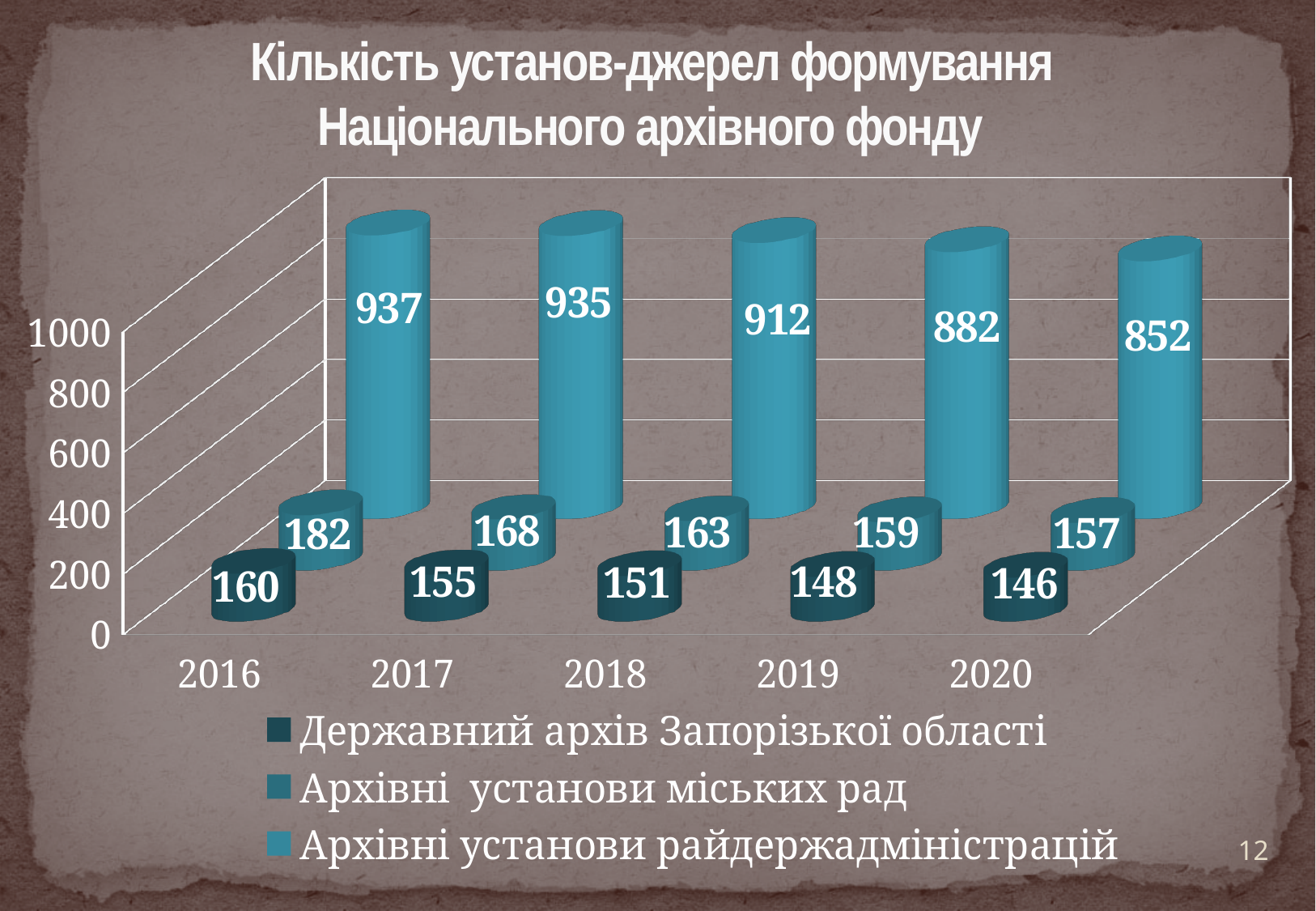
What is the value for Архівні установи райдержадміністрацій in 2016? 937 What is the title of the chart? Кількість установ-джерел формування Національного архівного фонду Which is larger: the 2017 value for Архівні установи міських рад or the 2017 value for Державний архів Запорізької області? Архівні установи міських рад What is the difference between the 2016 and 2020 values for Архівні установи райдержадміністрацій? 85 Do the values for Державний архів Запорізької області rise or fall from 2016 to 2020? fall In which year is the value for Архівні установи міських рад highest? 2016 What is the value for Державний архів Запорізької області in 2020? 146 How many series does the legend list? 3 In which year is the value for Архівні установи райдержадміністрацій lowest? 2020 What is the value for Архівні установи міських рад in 2018? 163 What kind of chart is shown on the slide? bar chart How many years are shown on the x axis? 5